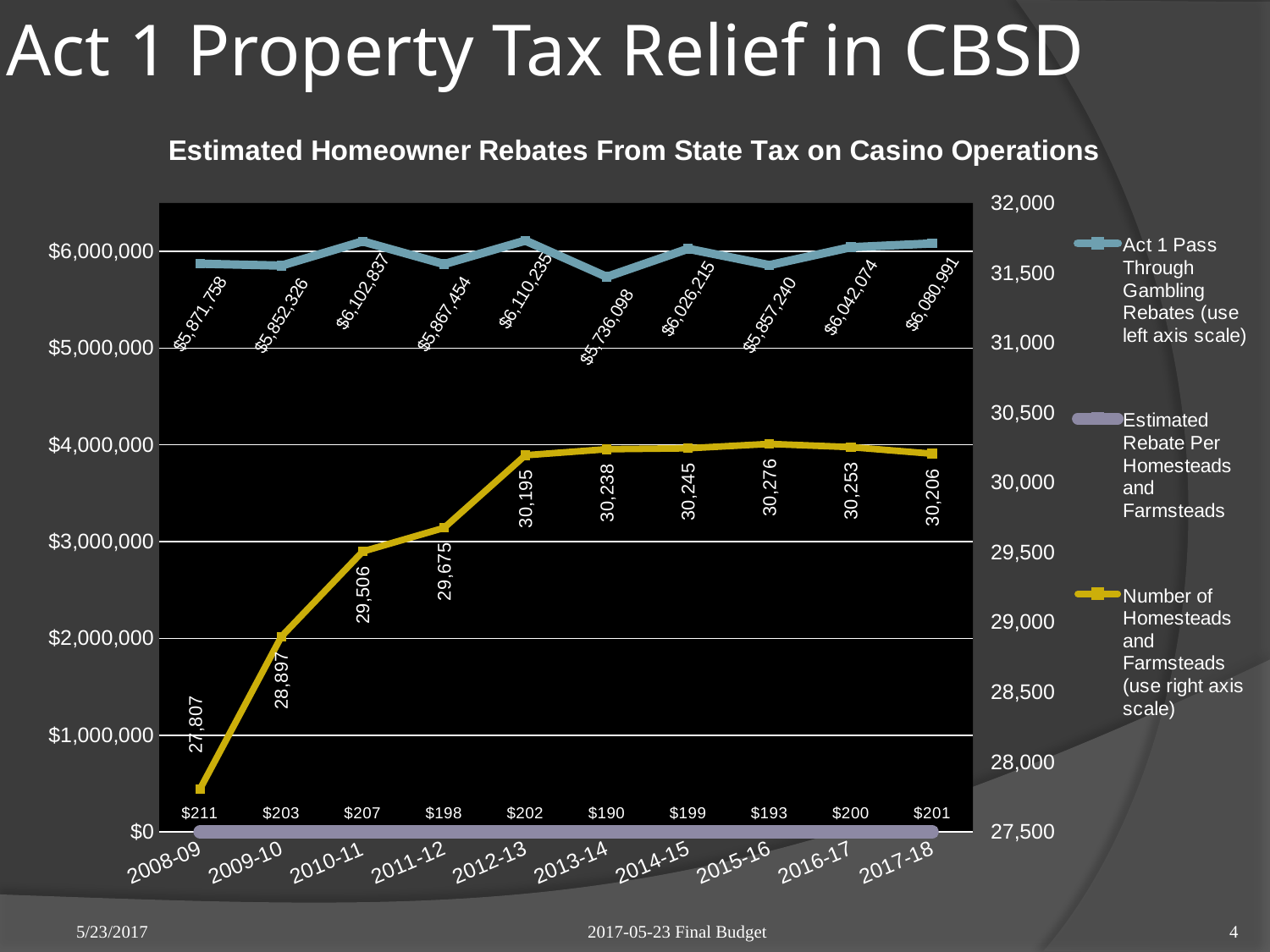
How many series does the legend list? 3 In which year are the Act 1 Pass Through Gambling Rebates the lowest? 2013-14 What is the lowest Estimated Rebate Per Homesteads and Farmsteads shown? $190 What is the value of Act 1 Pass Through Gambling Rebates for 2012-13? $6,110,235 By how much did the Number of Homesteads and Farmsteads increase from 2008-09 to 2009-10? 1,090 What is the Estimated Rebate Per Homesteads and Farmsteads for 2013-14? $190 What is the Number of Homesteads and Farmsteads for 2008-09? 27,807 In which year is the Number of Homesteads and Farmsteads the highest? 2015-16 Which year has higher Act 1 Pass Through Gambling Rebates, 2010-11 or 2011-12? 2010-11 In which year are the Act 1 Pass Through Gambling Rebates the highest? 2012-13 How many years are shown on the x axis? 10 What kind of chart is shown on the slide? Line chart